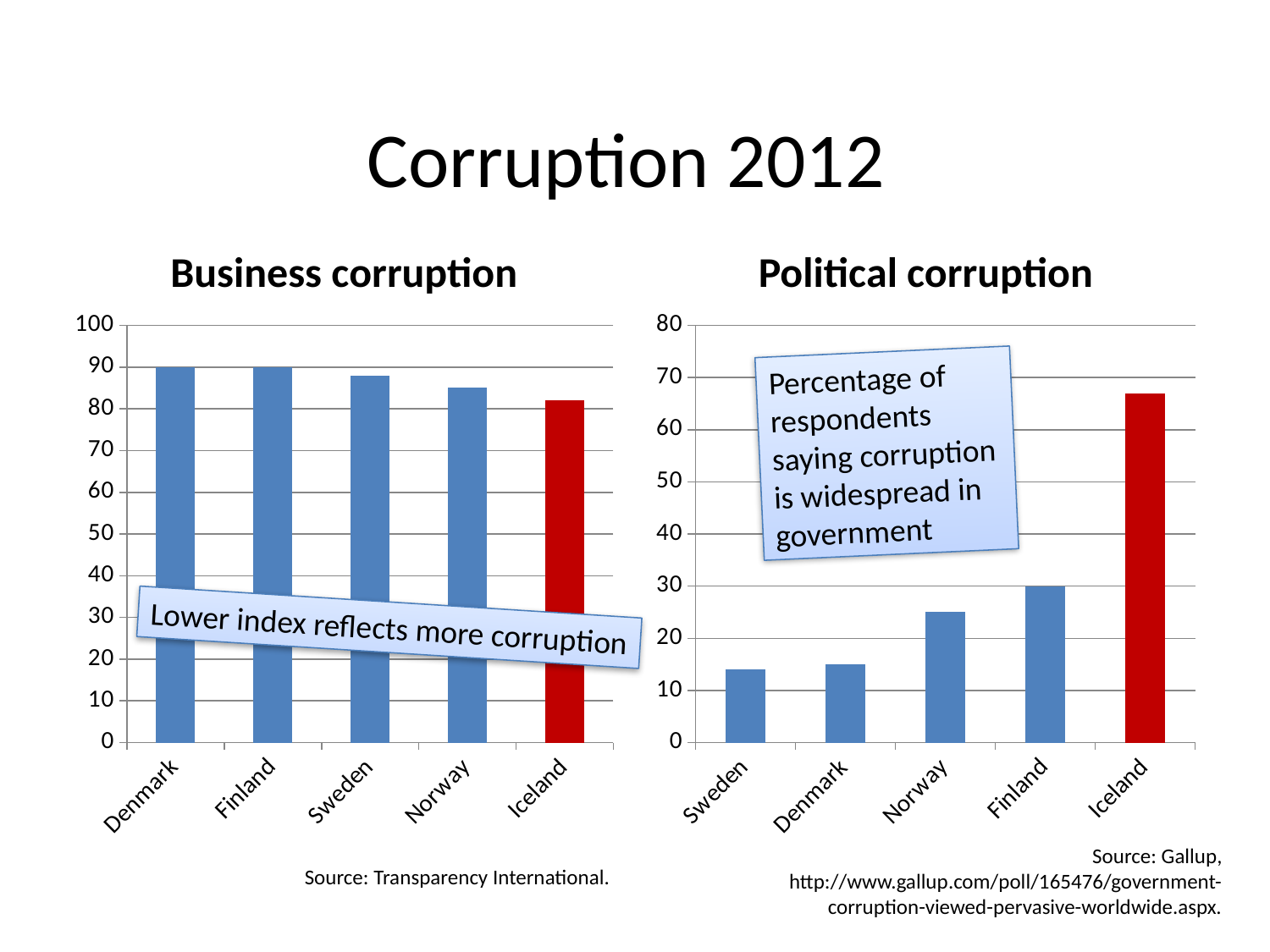
In the Business corruption chart, is the value for Iceland greater or less than 80? greater In the Business corruption chart, is the value for Norway greater or less than 90? less Which country's bar is coloured red in both charts? Iceland In the Political corruption chart, is the value for Iceland greater or less than 60? greater In the Political corruption chart, which country has the lowest value? Sweden What kind of chart is the Business corruption chart? bar chart In the Political corruption chart, which country has the highest value? Iceland In the Business corruption chart, which country has the lowest index? Iceland How many countries are shown in the Political corruption chart? 5 In the Business corruption chart, which is larger, the value for Denmark or the value for Iceland? Denmark In the Political corruption chart, which is larger, the value for Finland or the value for Norway? Finland